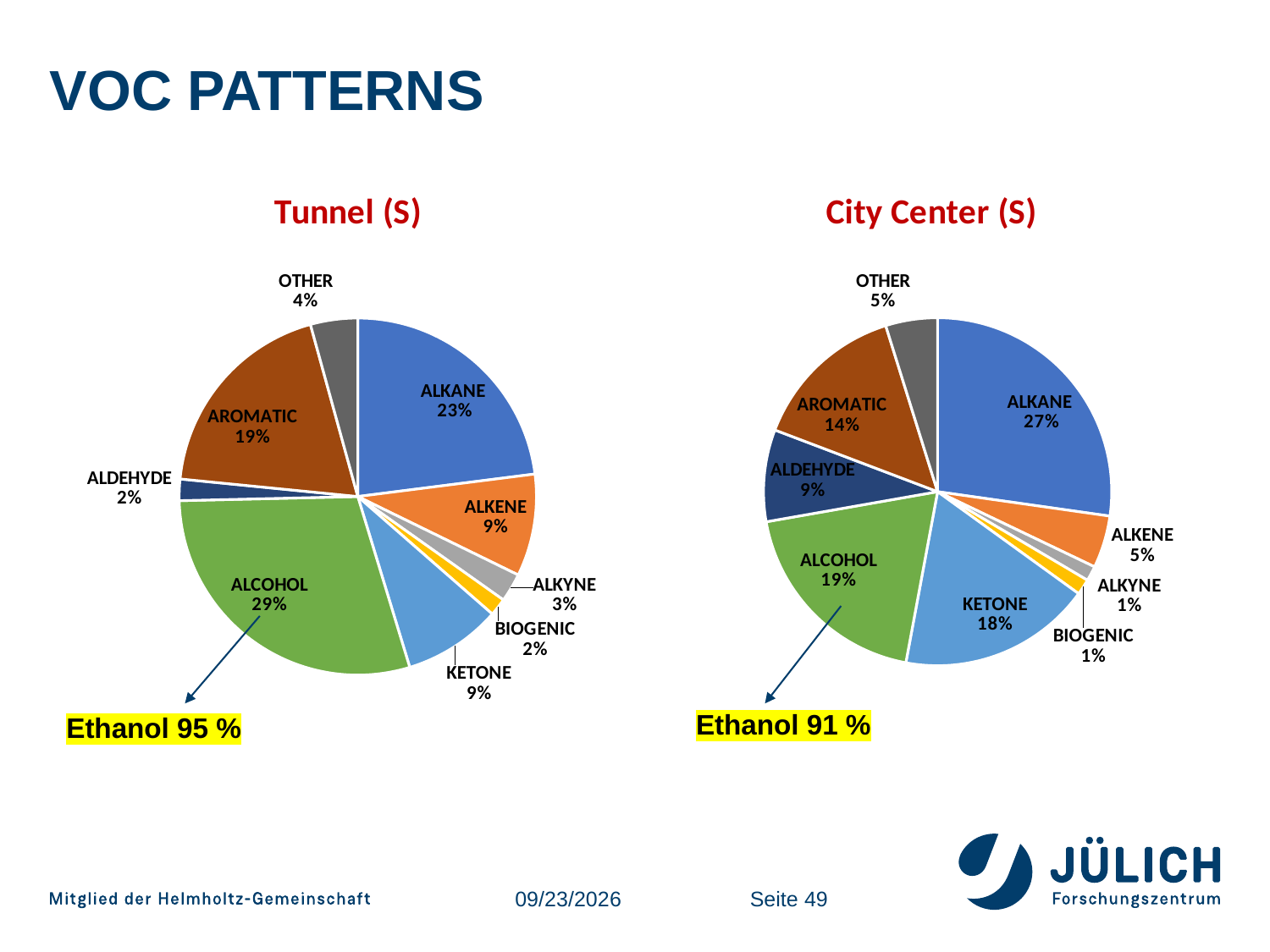
How many categories are shown in the Tunnel (S) pie chart? 9 In the Tunnel (S) chart, which category has the largest slice? ALCOHOL What type of chart is used for City Center (S)? Pie chart In the Tunnel (S) chart, what is the difference between the ALKANE and AROMATIC shares? 4% In the City Center (S) chart, which is larger, ALCOHOL or KETONE? ALCOHOL In the City Center (S) chart, which category has the largest slice? ALKANE In the City Center (S) chart, what share does ALKANE have? 27% In the Tunnel (S) chart, what share does BIOGENIC have? 2% In the City Center (S) chart, what share does ALDEHYDE have? 9% In the Tunnel (S) chart, what share does ALCOHOL have? 29% In the City Center (S) chart, what is the difference between the ALKANE and ALCOHOL shares? 8% What is the title of the chart on the left? Tunnel (S)